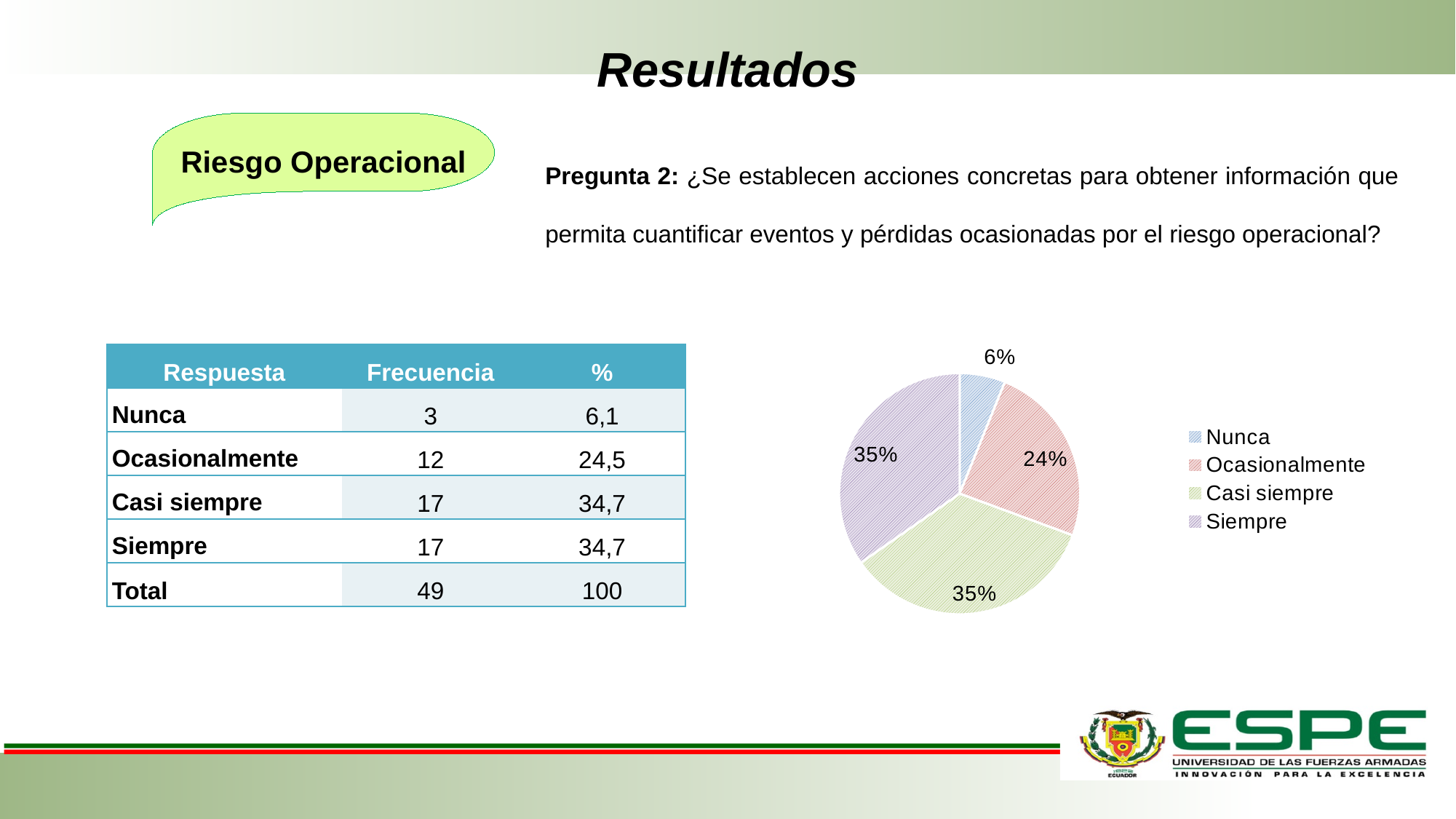
Which two categories in the pie chart have the same percentage? Casi siempre and Siempre What kind of chart is shown on the slide? pie chart Which legend entry in the pie chart is shown in purple? Siempre How many categories does the pie chart's legend list? 4 Which slice is larger in the pie chart, Ocasionalmente or Nunca? Ocasionalmente What is the difference in percentage points between the Ocasionalmente slice and the Nunca slice in the pie chart? 18 What is the difference in percentage points between the Siempre slice and the Ocasionalmente slice in the pie chart? 11 What percentage does the pie chart show for Ocasionalmente? 24% Which category has the smallest slice in the pie chart? Nunca What percentage does the pie chart show for Casi siempre? 35% What percentage does the pie chart show for Nunca? 6% What percentage does the pie chart show for Siempre? 35%